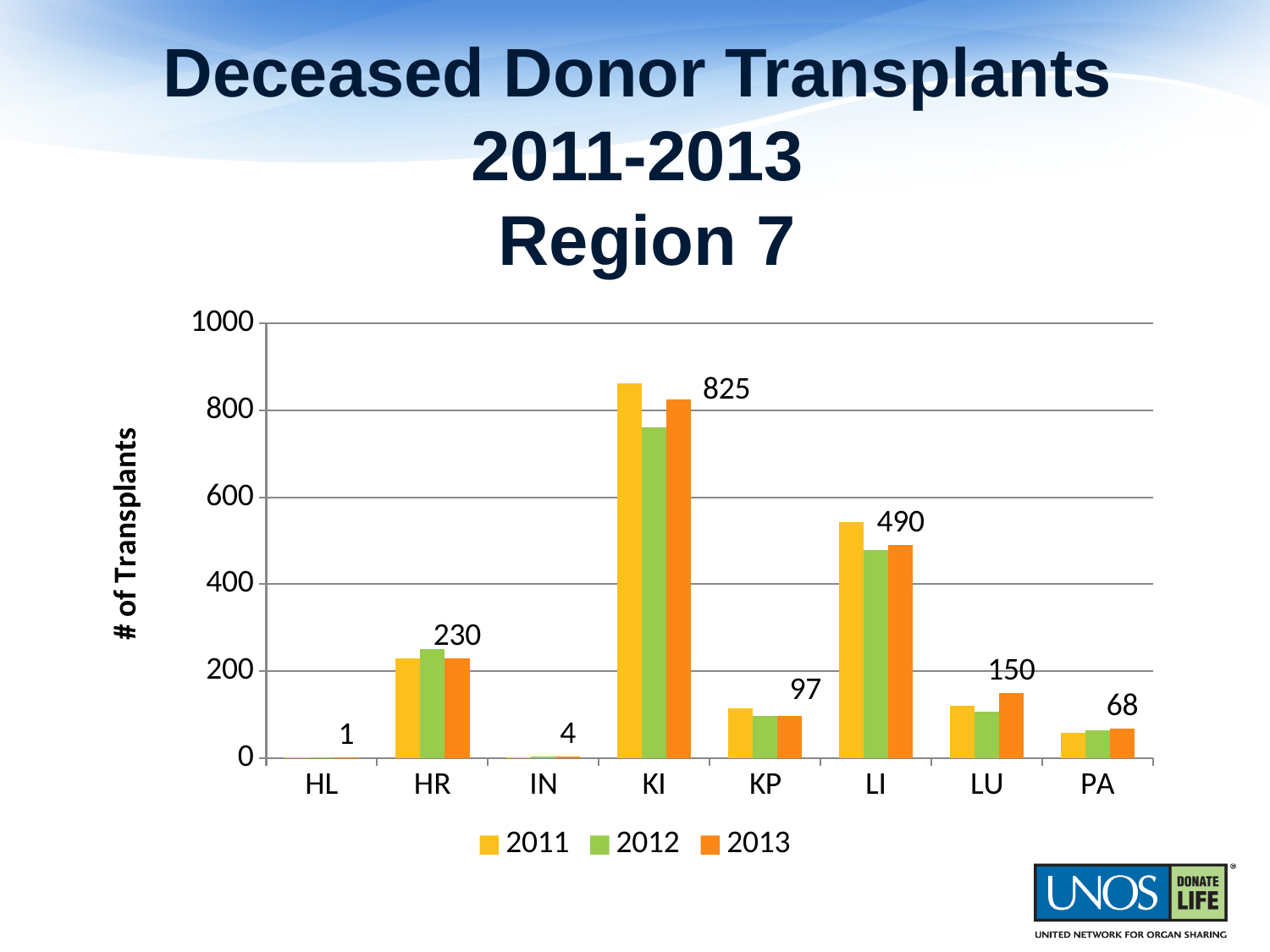
What is the number of deceased donor transplants for KI in 2013? 825 What is the 2013 value for HR? 230 In 2013, which is larger: the value for KP or the value for LU? LU How many series does the legend list? 3 Which organ category has the highest number of transplants in 2013? KI What kind of chart is shown on the slide? bar chart What is the 2013 value for LI? 490 What is the 2013 value for PA? 68 Is the 2011 value for KI greater or less than 800? greater What is the difference between the 2013 values for KI and LI? 335 How many organ categories are shown on the x axis? 8 Which organ category has the lowest number of transplants in 2013? HL